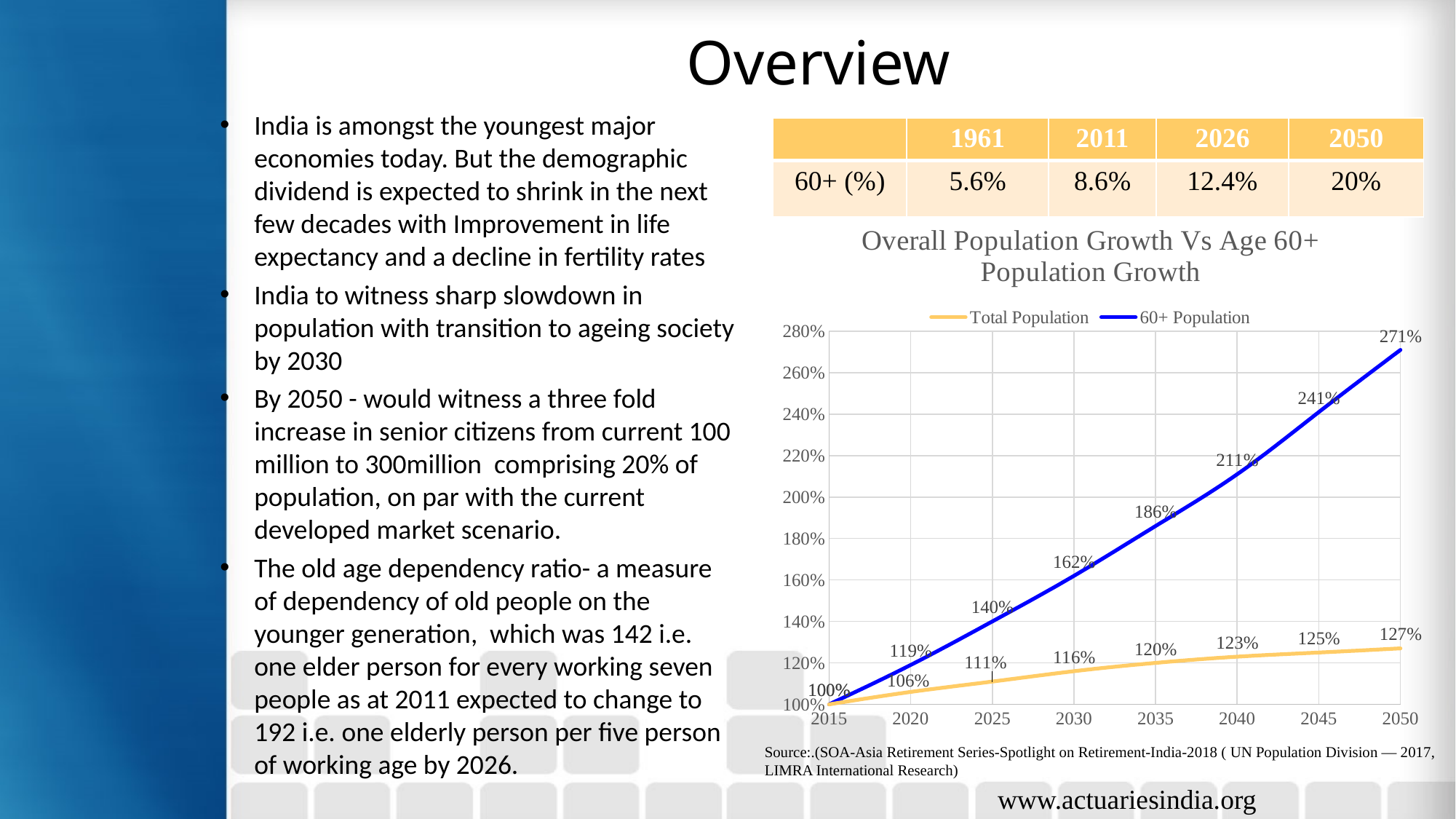
What is the difference between the 60+ Population and Total Population values in 2040? 88% What is the value of the 60+ Population series in 2050? 271% In which year does the 60+ Population series reach its highest value? 2050 Which series has the larger value in 2025, Total Population or 60+ Population? 60+ Population What type of chart is shown on the slide? line chart What is the value of the 60+ Population series in 2030? 162% What is the value of the Total Population series in 2035? 120% How many series does the chart legend list? 2 What is the title of the chart? Overall Population Growth Vs Age 60+ Population Growth How many years are shown on the x axis of the chart? 8 What is the value of the Total Population series in 2050? 127% Does the 60+ Population series rise or fall from 2015 to 2050? rise